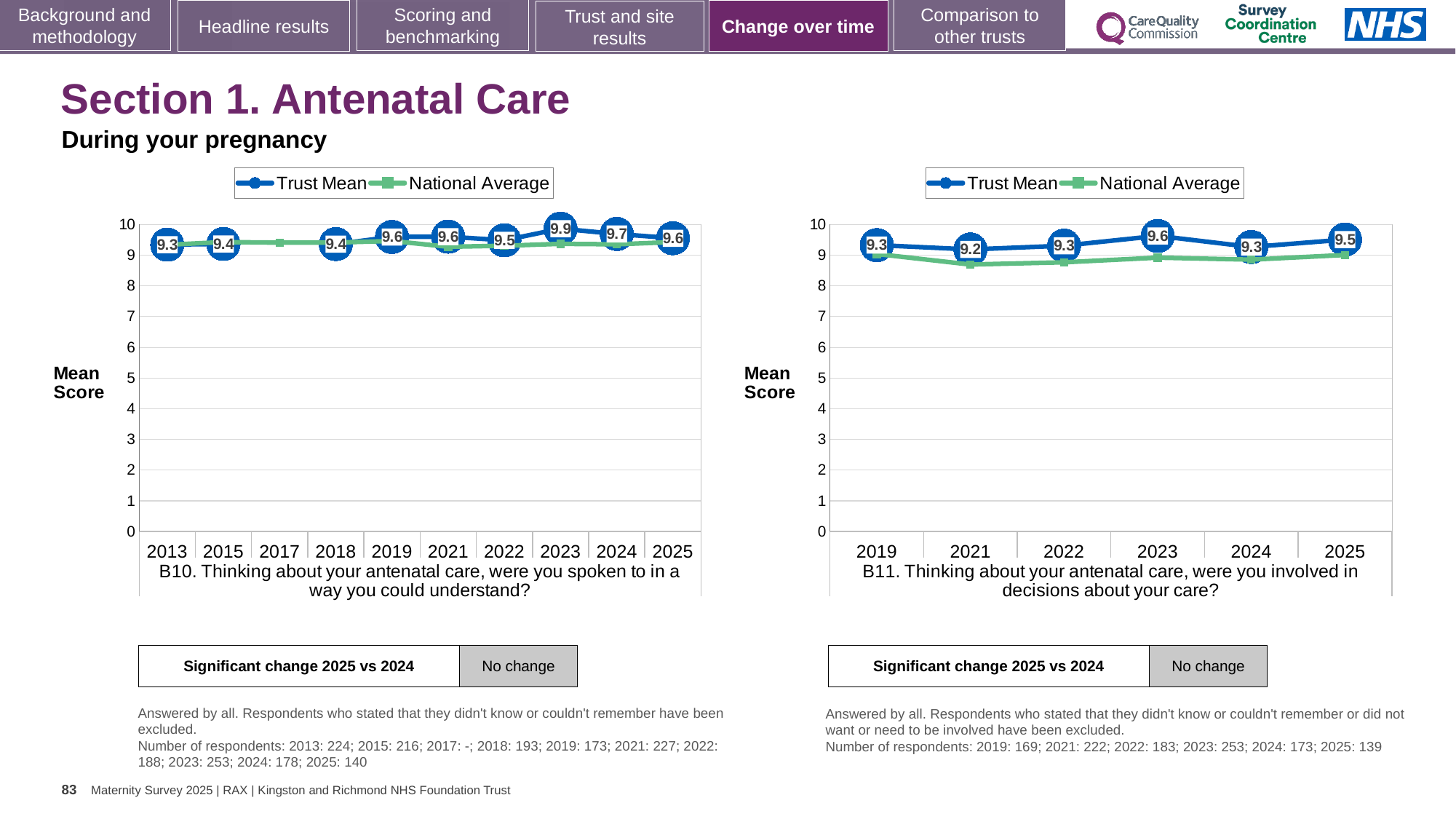
In the B10 chart on the left, what is the Trust Mean for 2023? 9.9 In the B11 chart on the right, which year has the highest Trust Mean? 2023 In the B11 chart on the right, what is the Trust Mean for 2025? 9.5 In the B11 chart on the right, is the National Average for 2021 greater or less than 9? less In the B11 chart on the right, is the Trust Mean higher in 2023 or in 2024? 2023 In the B10 chart on the left, what is the Trust Mean for 2013? 9.3 In the B11 chart on the right, which year has the lowest Trust Mean? 2021 In the B10 chart on the left, what is the difference between the Trust Mean in 2023 and in 2025? 0.3 In the B10 chart on the left, how many years are shown on the x axis? 10 What type of chart is the B11 chart on the right? Line chart In the B11 chart on the right, how many series does the legend list? 2 In the B10 chart on the left, which year has the highest Trust Mean? 2023